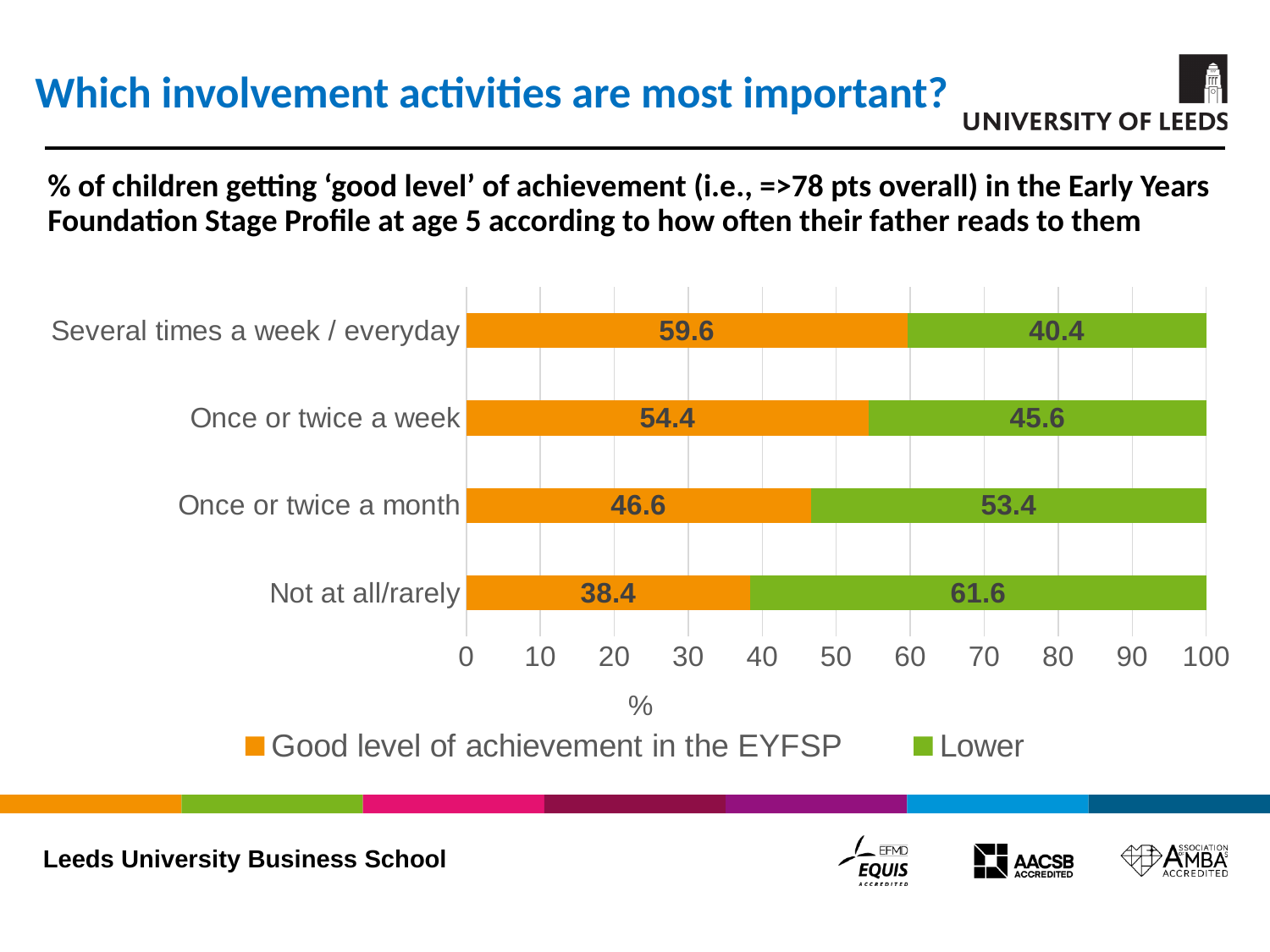
Which category has the highest value for 'Good level of achievement in the EYFSP'? Several times a week / everyday What is the difference between the 'Good level of achievement in the EYFSP' values for 'Several times a week / everyday' and 'Not at all/rarely'? 21.2 What is the value for 'Good level of achievement in the EYFSP' for 'Several times a week / everyday'? 59.6 What kind of chart is shown on the slide? Stacked bar chart What is the label of the x axis? % Which is larger: the 'Lower' value for 'Once or twice a week' or for 'Once or twice a month'? Once or twice a month What is the value for 'Good level of achievement in the EYFSP' for 'Not at all/rarely'? 38.4 How many series does the legend list? 2 What is the total of the stacked bar for 'Once or twice a week'? 100 Which category has the lowest value for 'Lower'? Several times a week / everyday What is the value for 'Lower' for 'Once or twice a month'? 53.4 How many categories are shown on the chart? 4